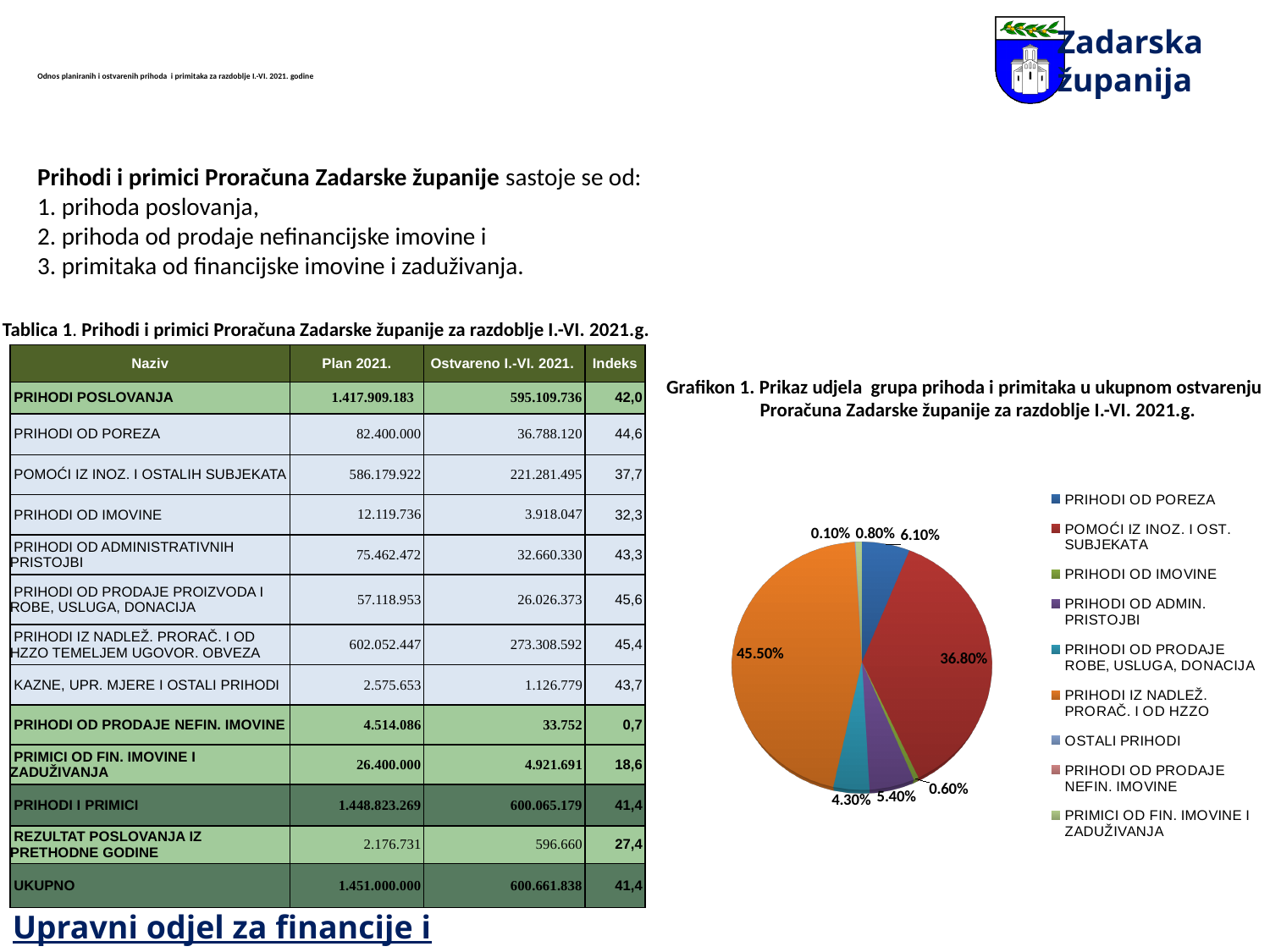
How many entries does the legend of Grafikon 1 list? 9 In Grafikon 1, what share is shown for POMOĆI IZ INOZ. I OST. SUBJEKATA? 36.80% What colour is the largest slice in Grafikon 1? Orange What is the title of the pie chart on the slide? Grafikon 1. Prikaz udjela grupa prihoda i primitaka u ukupnom ostvarenju Proračuna Zadarske županije za razdoblje I.-VI. 2021.g. In Grafikon 1, what share is shown for PRIHODI OD IMOVINE? 0.60% In Grafikon 1, which slice is larger: PRIHODI OD ADMIN. PRISTOJBI or PRIHODI OD PRODAJE ROBE, USLUGA, DONACIJA? PRIHODI OD ADMIN. PRISTOJBI In Grafikon 1, what share is shown for PRIHODI IZ NADLEŽ. PRORAČ. I OD HZZO? 45.50% Which category has the largest slice in Grafikon 1? PRIHODI IZ NADLEŽ. PRORAČ. I OD HZZO In Grafikon 1, what share is shown for PRIHODI OD POREZA? 6.10% In Grafikon 1, what share is shown for PRIMICI OD FIN. IMOVINE I ZADUŽIVANJA? 0.80% In Grafikon 1, how many percentage points larger is the PRIHODI IZ NADLEŽ. PRORAČ. I OD HZZO slice than the POMOĆI IZ INOZ. I OST. SUBJEKATA slice? 8.70 percentage points What kind of chart is Grafikon 1 on the slide? Pie chart